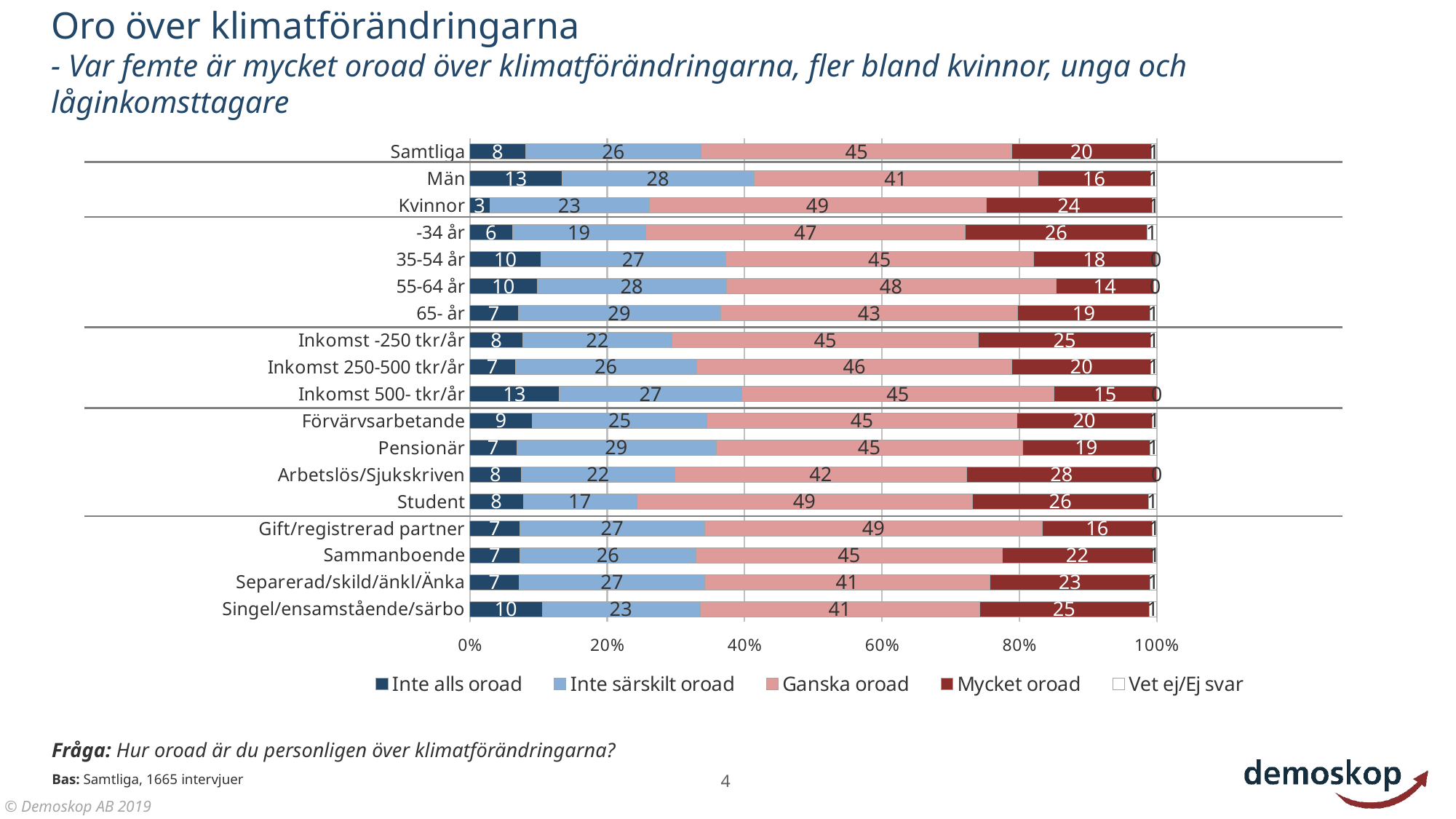
Which category has the highest value for 'Mycket oroad'? Arbetslös/Sjukskriven Which is larger: the 'Mycket oroad' value for -34 år or for 65- år? -34 år How many series does the legend list? 5 How many categories (rows) are plotted in the chart? 18 What is the value of 'Inte särskilt oroad' for Student? 17 What is the difference between the 'Mycket oroad' values for Kvinnor and Män? 8 What is the value of 'Mycket oroad' for Kvinnor? 24 Which category has the lowest value for 'Inte alls oroad'? Kvinnor What is the value of 'Ganska oroad' for 55-64 år? 48 Which category has the lowest value for 'Mycket oroad'? 55-64 år What kind of chart is shown on the slide? Stacked bar chart What is the label of the darkest red series in the legend? Mycket oroad